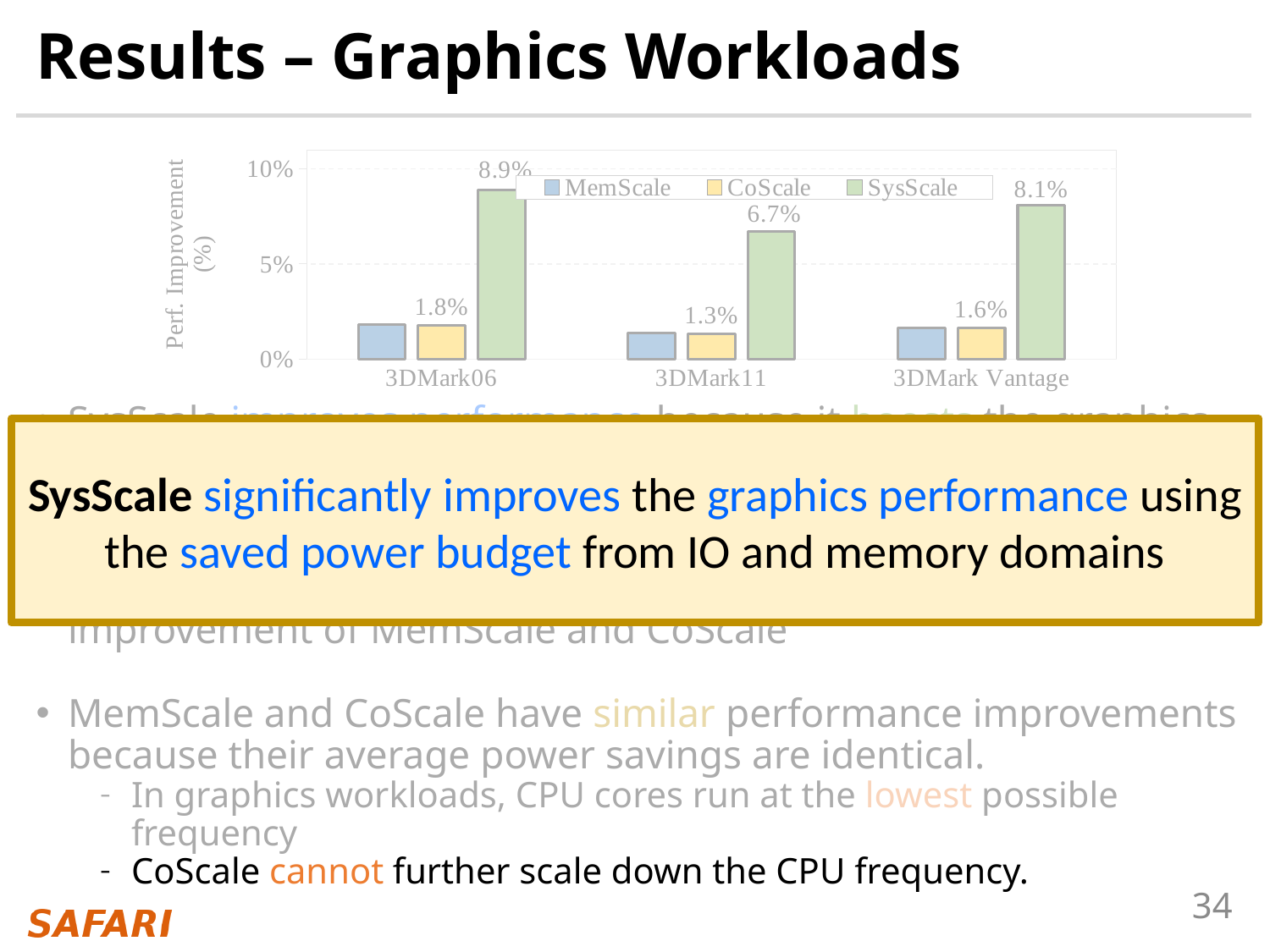
What kind of chart is shown on the slide? bar chart What is the difference between the SysScale and CoScale performance improvements on 3DMark11? 5.4% Which is larger: the SysScale improvement on 3DMark06 or on 3DMark Vantage? 3DMark06 What is the performance improvement for CoScale on 3DMark06? 1.8% How many series does the chart's legend list? 3 What is the performance improvement for SysScale on 3DMark06? 8.9% What is the performance improvement for SysScale on 3DMark Vantage? 8.1% On which benchmark does SysScale achieve its highest performance improvement? 3DMark06 What is the performance improvement for SysScale on 3DMark11? 6.7% How many benchmarks are shown on the x axis of the chart? 3 On which benchmark does SysScale achieve its lowest performance improvement? 3DMark11 Is the value for MemScale on 3DMark06 greater or less than 5%? less